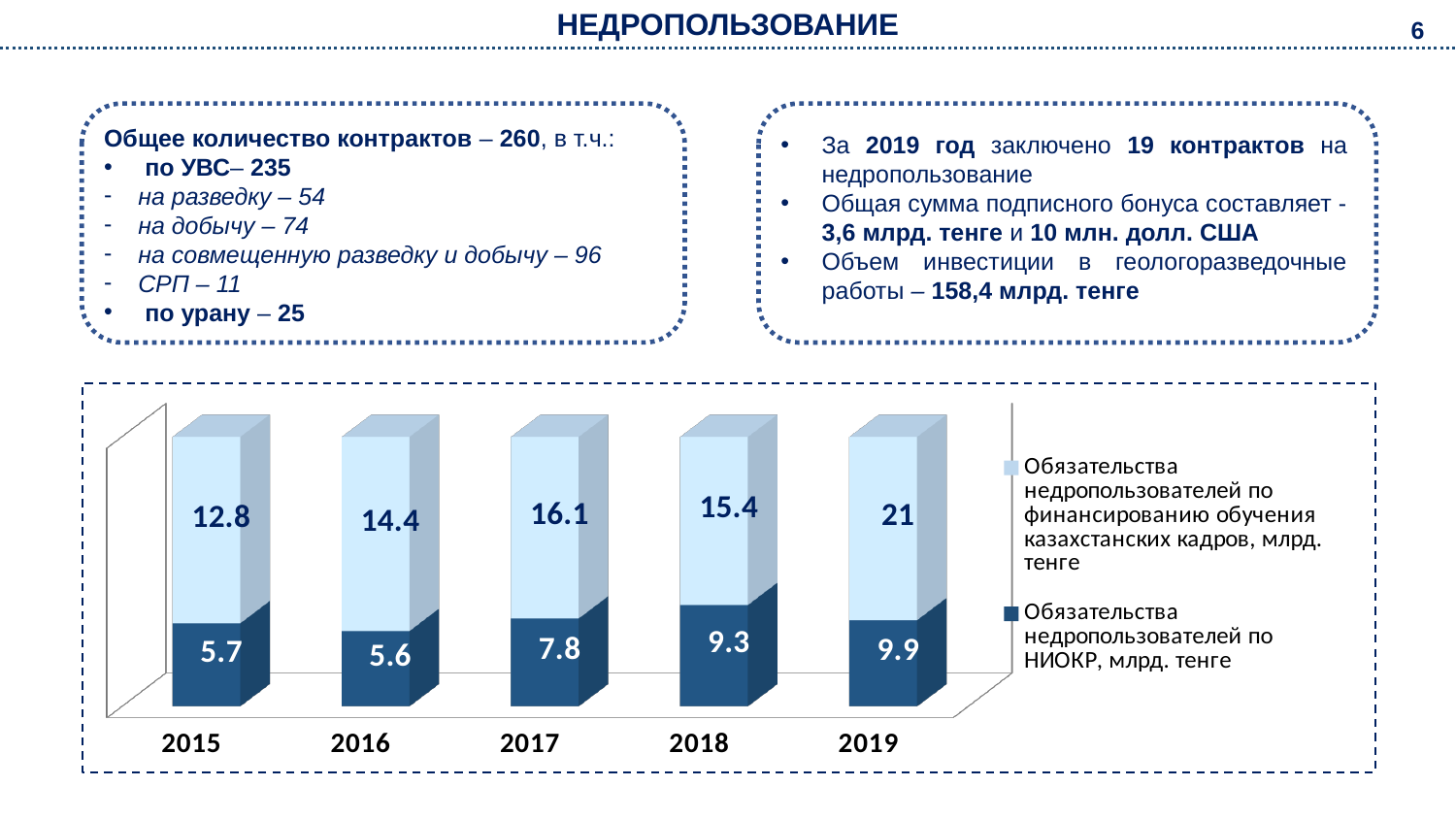
Which is larger: the R&D obligations in 2018 or in 2016? 2018 Which year has the lowest value for training funding obligations? 2015 How many series does the chart legend list? 2 What is the value of the training funding obligations (Обязательства недропользователей по финансированию обучения казахстанских кадров) for 2019? 21 What type of chart is shown on the slide? Stacked bar chart Which colour represents the R&D obligations (НИОКР) series in the chart? Dark blue What is the total of the stacked bar for 2019? 30.9 What is the value of the training funding obligations for 2015? 12.8 How many years are shown on the x axis of the chart? 5 What is the value of the R&D obligations (Обязательства недропользователей по НИОКР) for 2017? 7.8 Which year has the highest value for R&D obligations (НИОКР)? 2019 What is the difference between the training funding obligations in 2019 and in 2018? 5.6